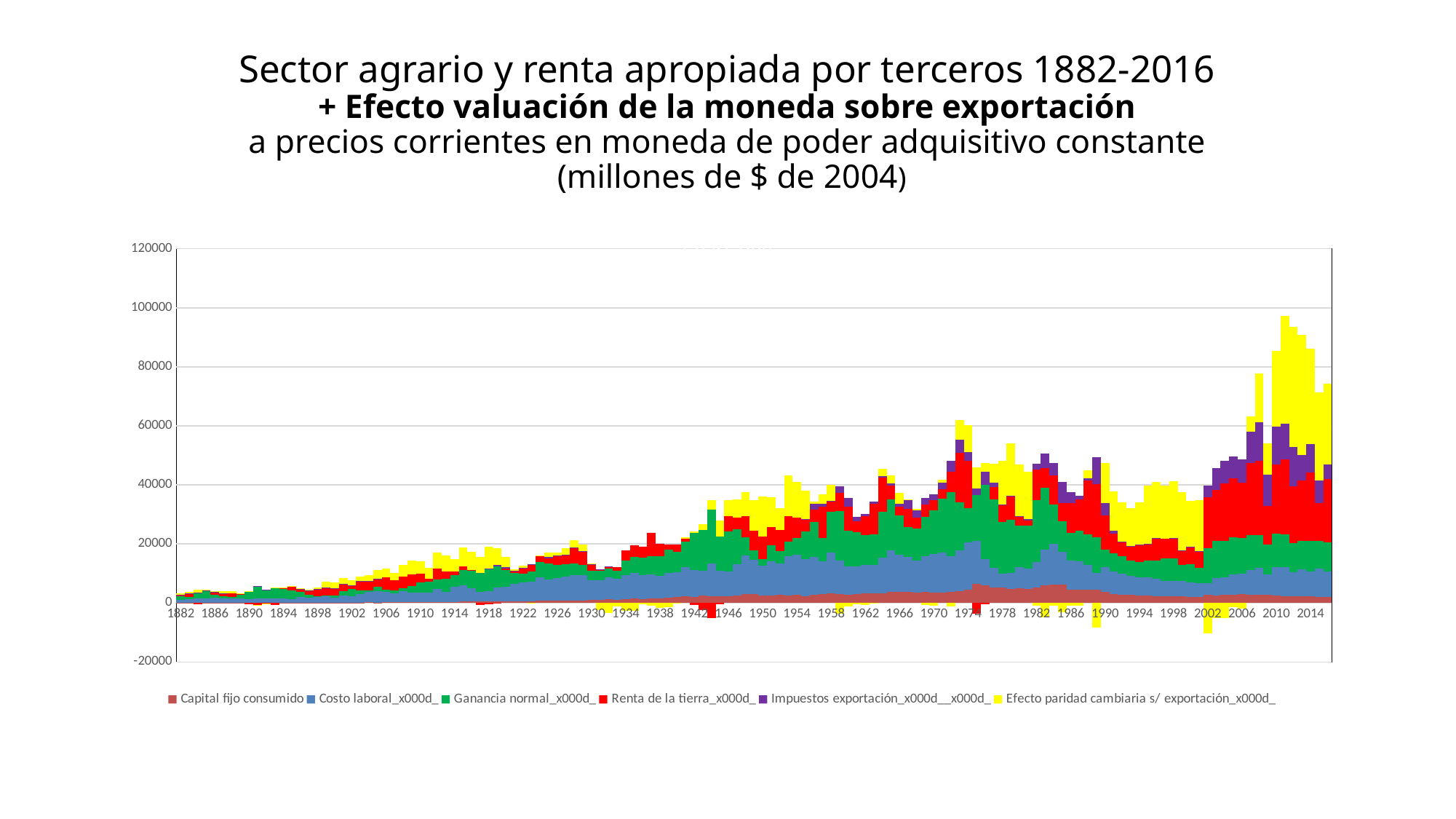
Overall, do the total stacked values rise or fall from 1882 to 2016? Rise What is the first series listed in the legend? Capital fijo consumido What is the lowest value shown on the vertical axis? -20000 Is the total stacked value for 1950 greater or less than 20000? greater Which series is shown in yellow in the legend? Efecto paridad cambiaria s/ exportación_x000d_ What kind of chart is shown on the slide? Stacked bar chart Which year has the larger total stacked value, 1882 or 2010? 2010 Does the highest stacked bar in the chart exceed 100000? No Is the total stacked value for 1882 greater or less than 20000? less How many series does the legend list? 6